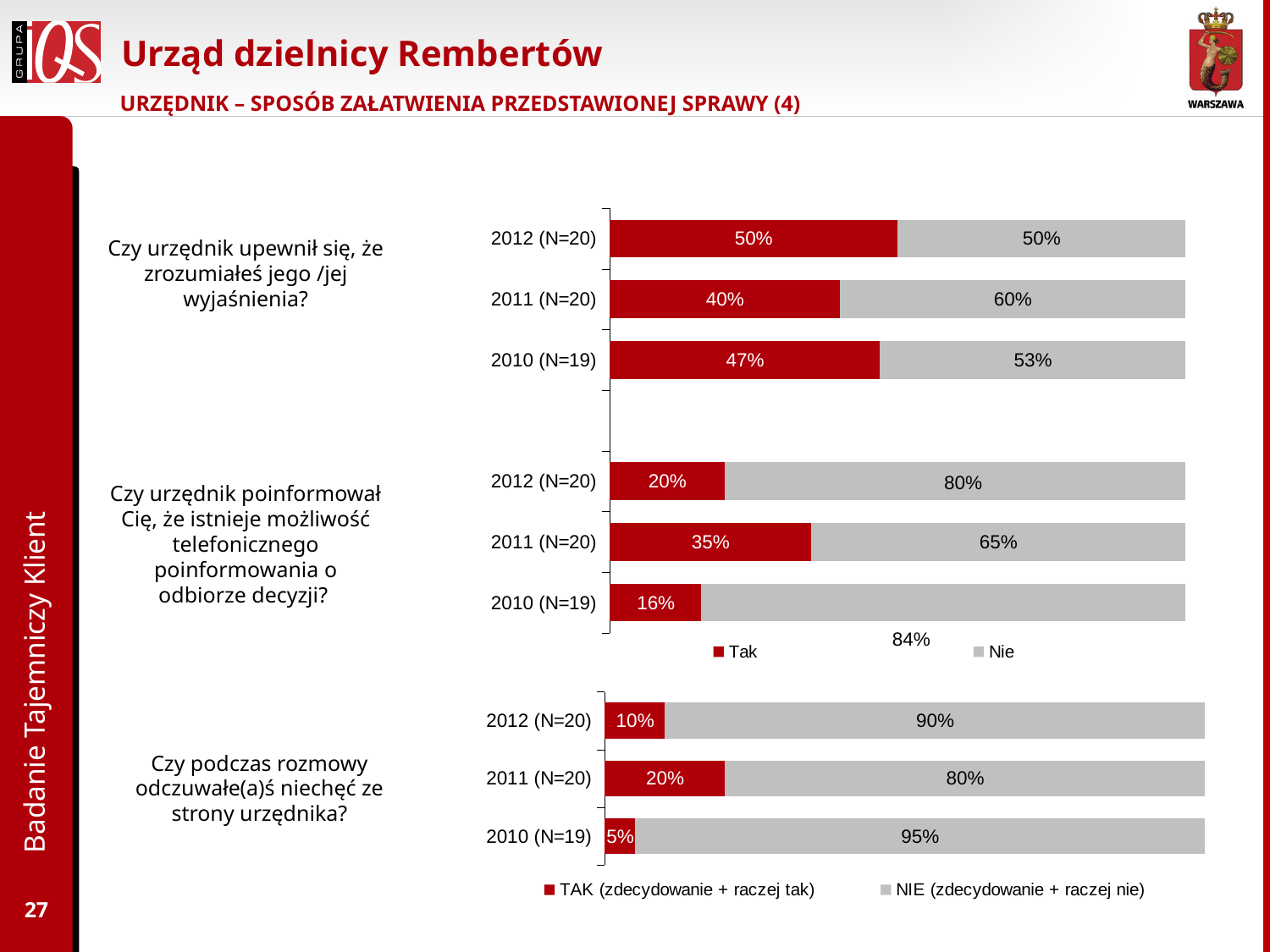
In the chart for "Czy urzędnik poinformował Cię, że istnieje możliwość telefonicznego poinformowania o odbiorze decyzji?", which year has the lowest Tak value? 2010 (N=19) What kind of chart is used on this slide? Stacked bar chart How many year categories are shown in the chart for "Czy podczas rozmowy odczuwałe(a)ś niechęć ze strony urzędnika?"? 3 In the chart for "Czy urzędnik upewnił się, że zrozumiałeś jego /jej wyjaśnienia?", what is the Nie value for 2010 (N=19)? 53% In the chart for "Czy urzędnik upewnił się, że zrozumiałeś jego /jej wyjaśnienia?", what is the Tak value for 2011 (N=20)? 40% In the chart for "Czy urzędnik poinformował Cię, że istnieje możliwość telefonicznego poinformowania o odbiorze decyzji?", which year has the highest Tak value? 2011 (N=20) In the chart for "Czy podczas rozmowy odczuwałe(a)ś niechęć ze strony urzędnika?", which year has the highest NIE value? 2010 (N=19) How many series does the legend of the bottom chart list? 2 In the chart for "Czy urzędnik upewnił się, że zrozumiałeś jego /jej wyjaśnienia?", what is the total of the stacked bar for 2012 (N=20)? 100% In the chart for "Czy podczas rozmowy odczuwałe(a)ś niechęć ze strony urzędnika?", what is the TAK value for 2010 (N=19)? 5% In the chart for "Czy urzędnik poinformował Cię, że istnieje możliwość telefonicznego poinformowania o odbiorze decyzji?", what is the difference between the Nie values for 2012 (N=20) and 2011 (N=20)? 15% In the chart for "Czy podczas rozmowy odczuwałe(a)ś niechęć ze strony urzędnika?", is the TAK value larger for 2012 (N=20) or 2011 (N=20)? 2011 (N=20)